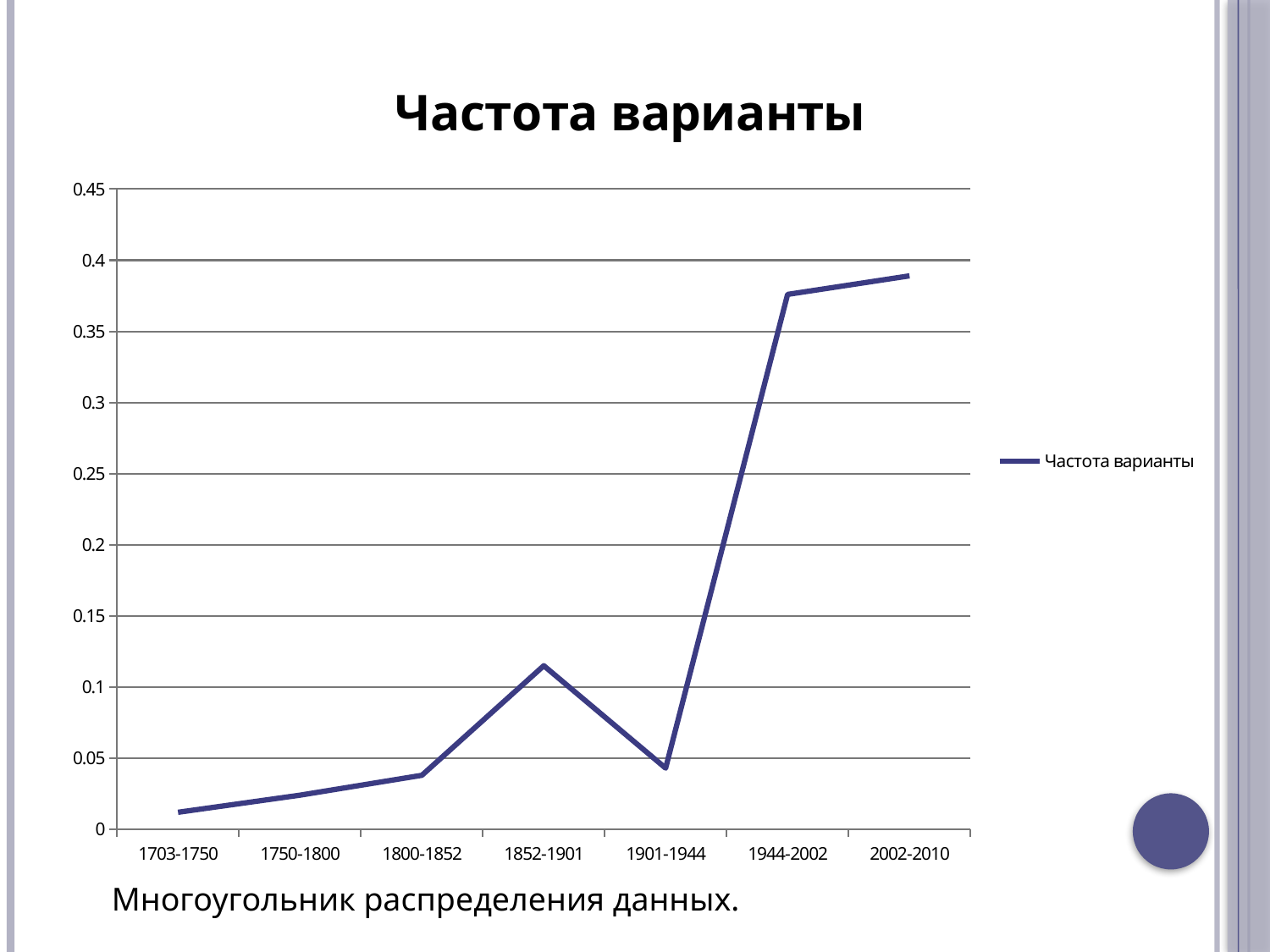
What kind of chart is shown on the slide? line chart Is the value for 1944-2002 greater or less than 0.35? greater Which category has the lowest value? 1703-1750 Which is larger, the value for 1852-1901 or the value for 1901-1944? 1852-1901 Is the value for 1852-1901 greater or less than 0.15? less How many categories are shown on the x axis? 7 How many series does the legend list? 1 Does the value rise or fall from 1901-1944 to 1944-2002? rise What is the title of the chart? Частота варианты Which is larger, the value for 1800-1852 or the value for 1944-2002? 1944-2002 Which category has the highest value? 2002-2010